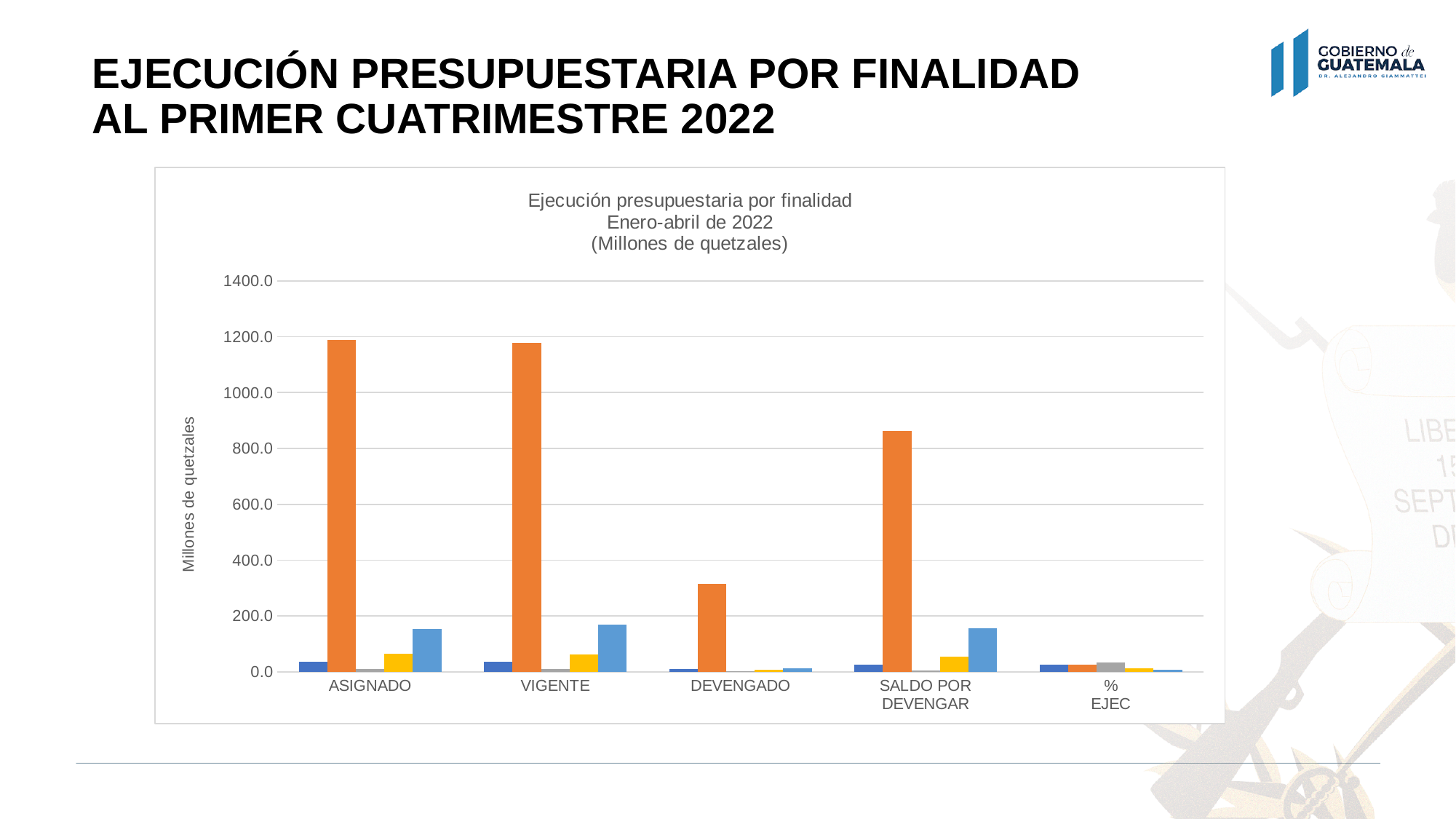
Is the value of the orange bar for DEVENGADO greater or less than 400? less Which category has the lowest orange bar? % EJEC What is the label of the vertical axis of the chart? Millones de quetzales Which has the larger orange bar, ASIGNADO or DEVENGADO? ASIGNADO Is the value of the orange bar for ASIGNADO greater or less than 1000? greater Is the value of the light blue bar for VIGENTE greater or less than 200? less Which has the larger orange bar, DEVENGADO or SALDO POR DEVENGAR? SALDO POR DEVENGAR How many categories are shown on the x axis of the chart? 5 What period does the chart title say the data covers? Enero-abril de 2022 What kind of chart is shown on the slide? bar chart